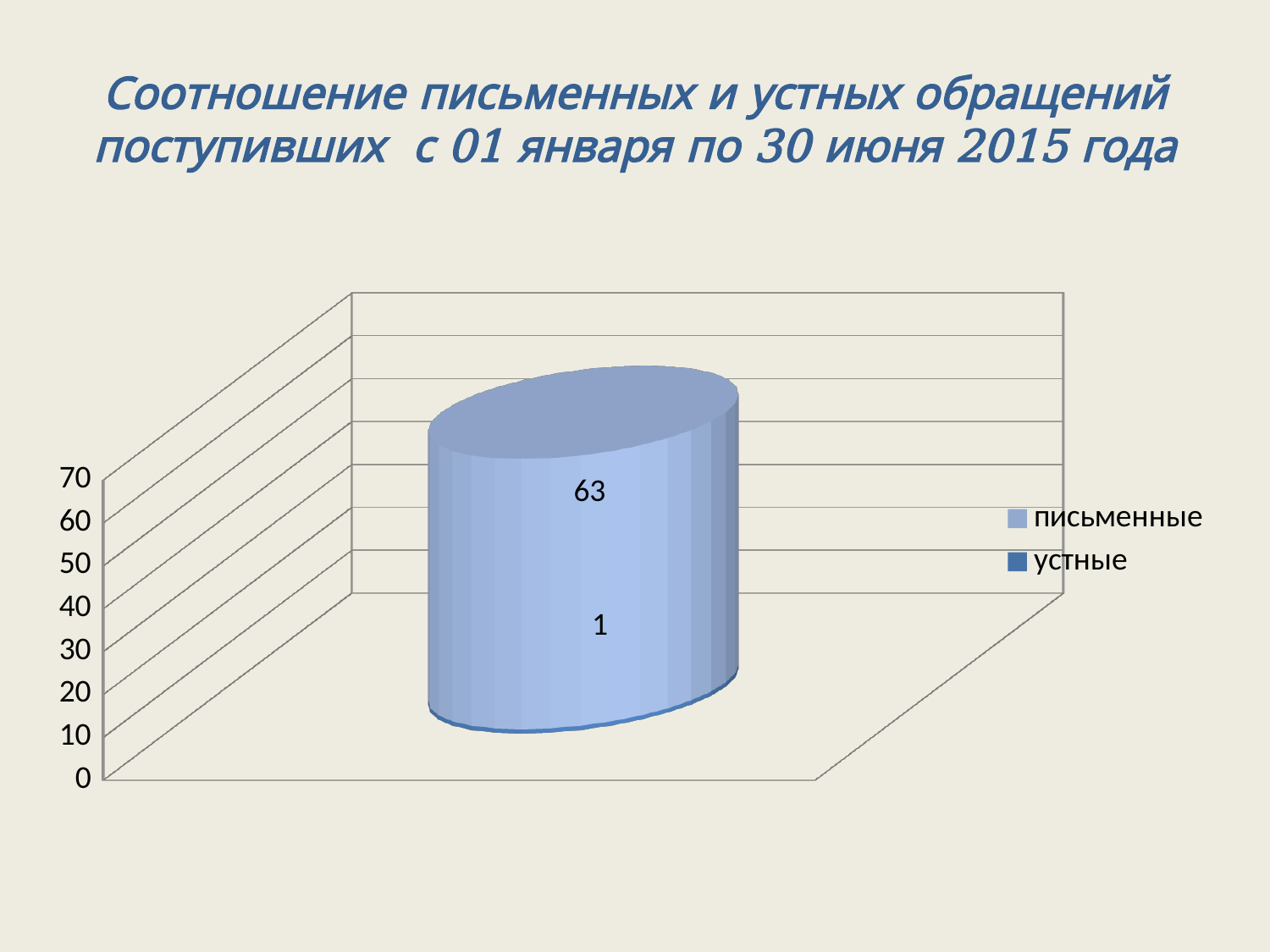
Which series has the lowest value? устные What kind of chart is shown on the slide? Stacked bar chart What is the maximum value shown on the vertical axis? 70 Is the value for письменные greater or less than 50? greater What is the difference between the values for письменные and устные? 62 What is the value for письменные? 63 Which series has the higher value, письменные or устные? письменные What is the title of the chart? Соотношение письменных и устных обращений поступивших с 01 января по 30 июня 2015 года What is the total of the stacked bar? 64 Which series has the highest value? письменные What is the value for устные? 1 How many series does the legend list? 2